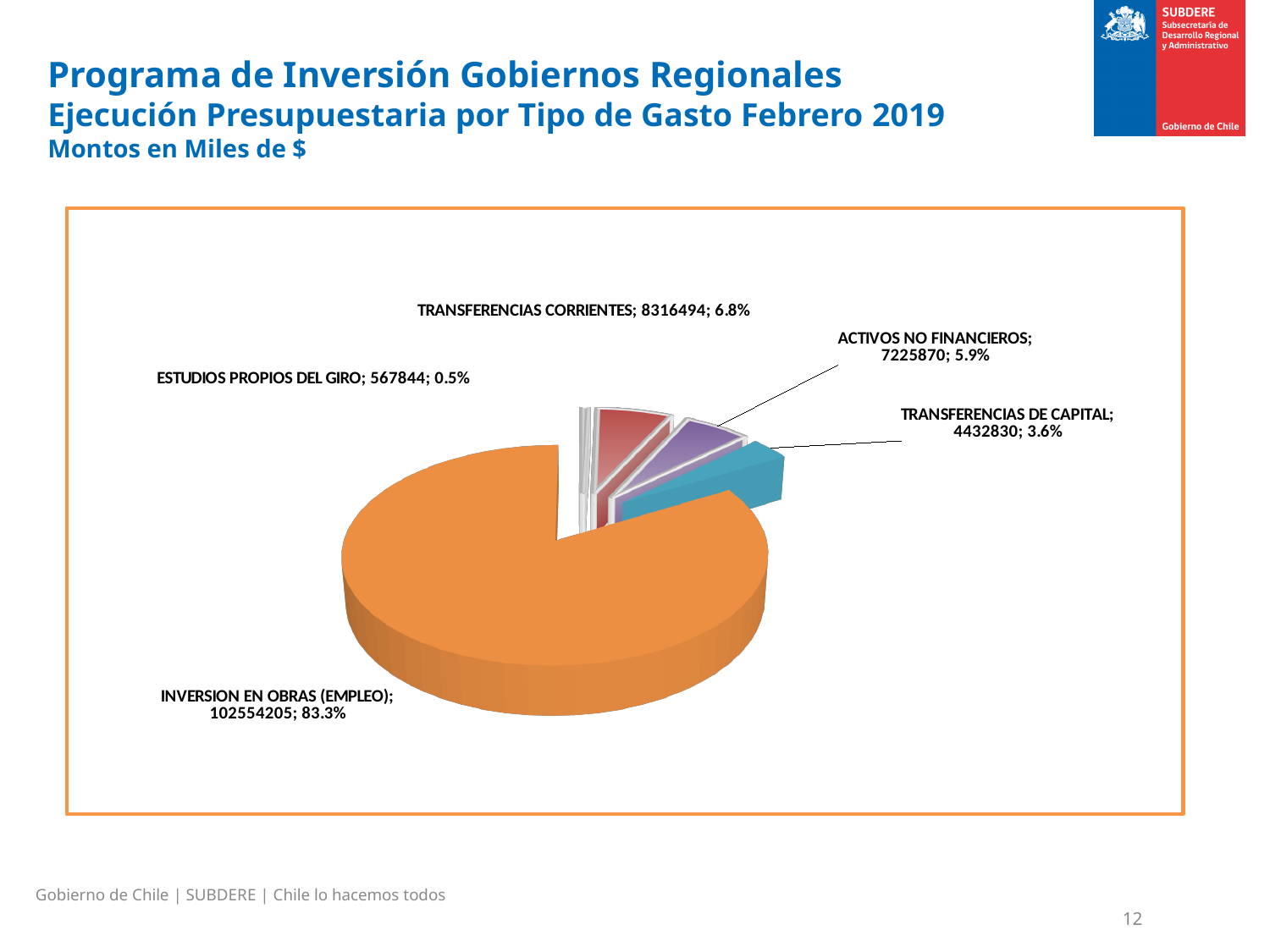
Which category has the largest slice of the pie? INVERSION EN OBRAS (EMPLEO) What is the value for INVERSION EN OBRAS (EMPLEO)? 102554205 Which category has the smallest slice of the pie? ESTUDIOS PROPIOS DEL GIRO What is the value for TRANSFERENCIAS DE CAPITAL? 4432830 What is the difference between the values for TRANSFERENCIAS CORRIENTES and ACTIVOS NO FINANCIEROS? 1090624 In what units are the amounts in the chart expressed, according to the slide subtitle? Miles de $ Which is larger, the value for ACTIVOS NO FINANCIEROS or the value for TRANSFERENCIAS DE CAPITAL? ACTIVOS NO FINANCIEROS What percentage of the pie is ACTIVOS NO FINANCIEROS? 5.9% What is the value for TRANSFERENCIAS CORRIENTES? 8316494 How many categories (slices) does the pie chart show? 5 What share of the pie does INVERSION EN OBRAS (EMPLEO) represent? 83.3% What type of chart is shown on the slide? Pie chart